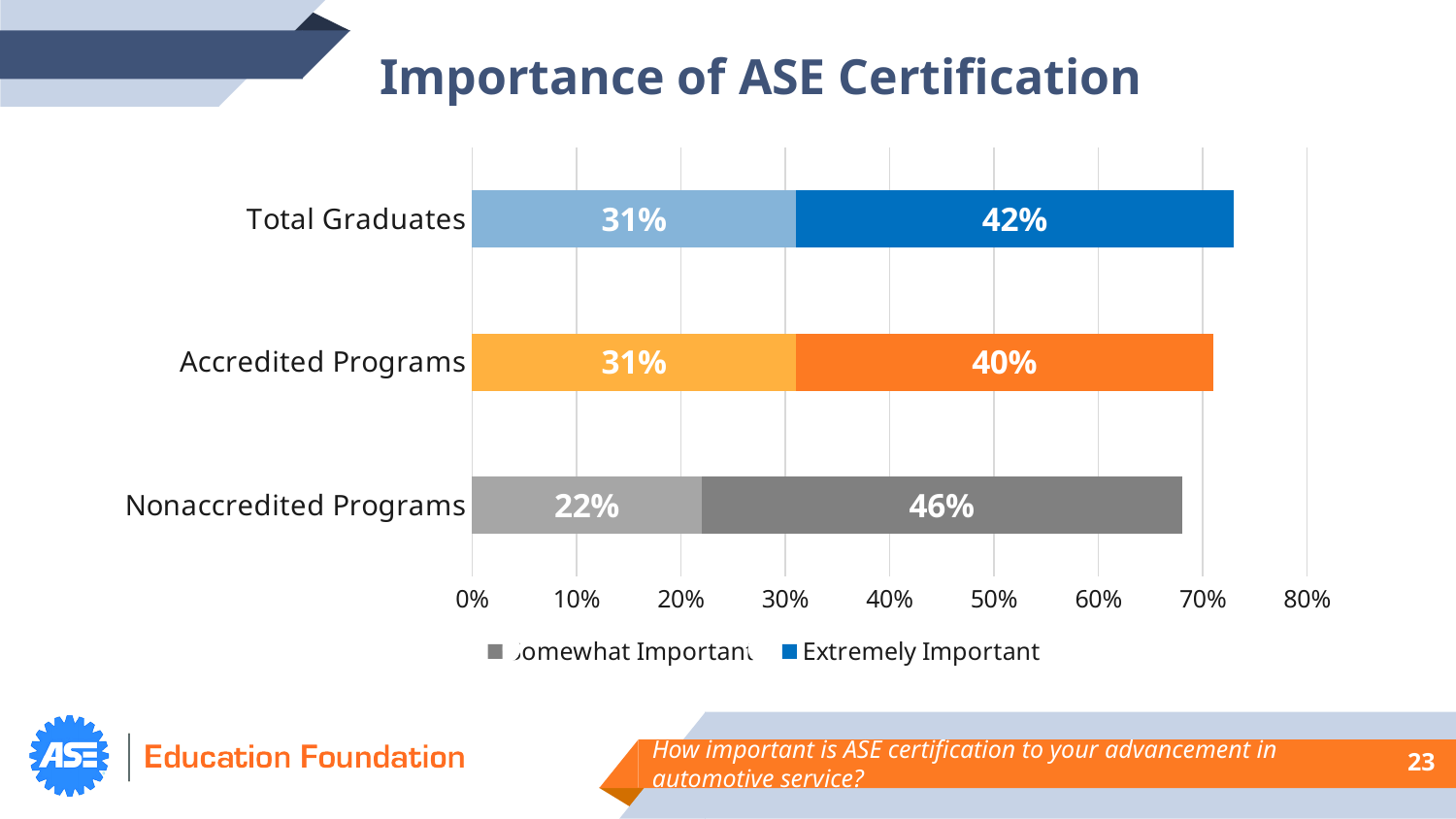
How many categories are shown on the chart? 3 What is the difference between the Extremely Important values for Nonaccredited Programs and Accredited Programs? 6% What is the total of the stacked bar for Total Graduates? 73% Which category has the highest Extremely Important value? Nonaccredited Programs What is the Extremely Important value for Accredited Programs? 40% What kind of chart is shown on the slide? Stacked bar chart What is the Somewhat Important value for Nonaccredited Programs? 22% What is the Extremely Important value for Total Graduates? 42% Which is larger: the Somewhat Important value for Total Graduates or for Nonaccredited Programs? Total Graduates Which category has the lowest Somewhat Important value? Nonaccredited Programs How many series does the legend list? 2 What is the total of the stacked bar for Nonaccredited Programs? 68%